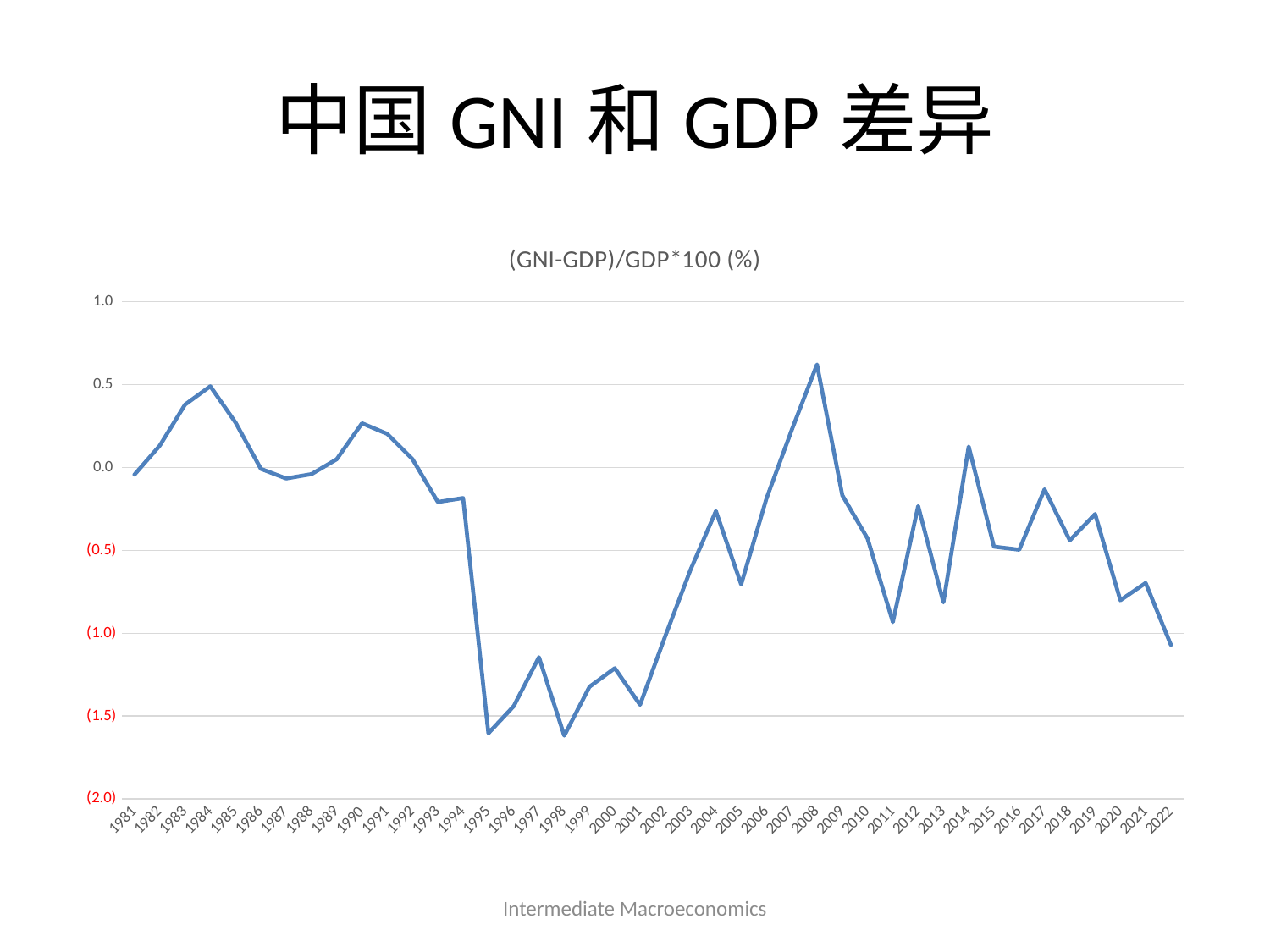
Is the value for 1995 greater or less than (1.5)? less Is the value for 1984 greater or less than 0.0? greater Does the value rise or fall from 1994 to 1995? fall Which year has the larger value, 1984 or 2008? 2008 Does the value rise or fall from 2005 to 2008? rise What kind of chart is shown on the slide? line chart Is the value for 2011 greater or less than (0.5)? less How many years are plotted along the x axis? 42 What is the title printed above the chart's plot area? (GNI-GDP)/GDP*100 (%) Which year has the highest value of (GNI-GDP)/GDP*100? 2008